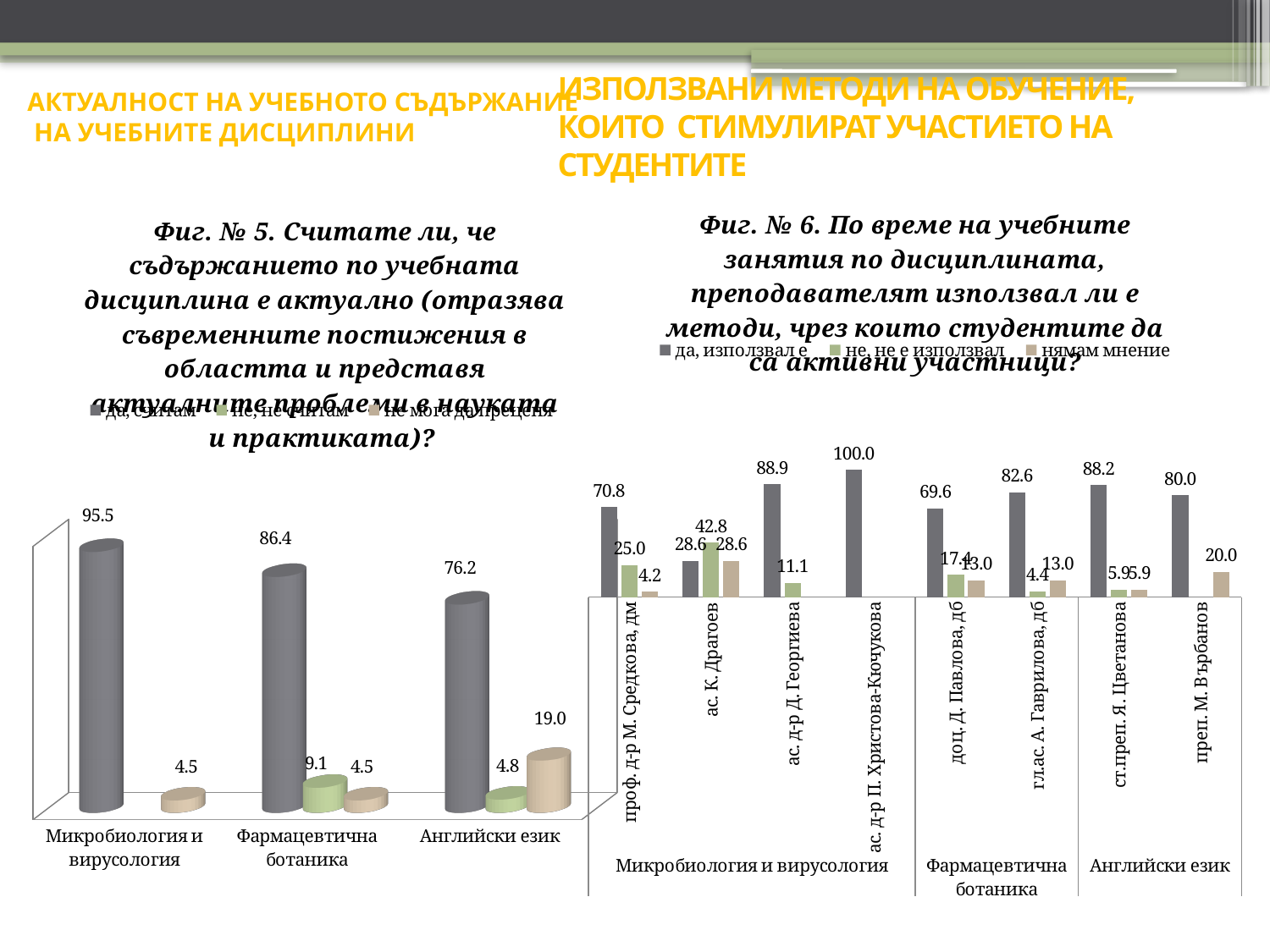
In the right chart (Фиг. № 6), how many lecturers are shown on the x axis? 8 In the left chart (Фиг. № 5), which discipline has the lowest "да, считам" value? Английски език In the right chart (Фиг. № 6), what is the difference between the "да, използвал е" values for ас. д-р Д. Георгиева and проф. д-р М. Средкова, дм? 18.1 In the left chart (Фиг. № 5), what is the value of "не мога да преценя" for Английски език? 19.0 In the right chart (Фиг. № 6), which is larger: the "да, използвал е" value for доц. Д. Павлова, дб or for гл.ас. А. Гаврилова, дб? гл.ас. А. Гаврилова, дб In the left chart (Фиг. № 5), how many disciplines are shown on the x axis? 3 How many series does the legend of the right chart (Фиг. № 6) list? 3 In the right chart (Фиг. № 6), what is the "нямам мнение" value for преп. М. Върбанов? 20.0 In the left chart (Фиг. № 5), what is the value of "да, считам" for Микробиология и вирусология? 95.5 In the right chart (Фиг. № 6), what is the "да, използвал е" value for ас. д-р П. Христова-Кючукова? 100.0 In the right chart (Фиг. № 6), which lecturer has the lowest "да, използвал е" value? ас. К. Драгоев In the left chart (Фиг. № 5), what is the difference between the "да, считам" values for Микробиология и вирусология and Фармацевтична ботаника? 9.1